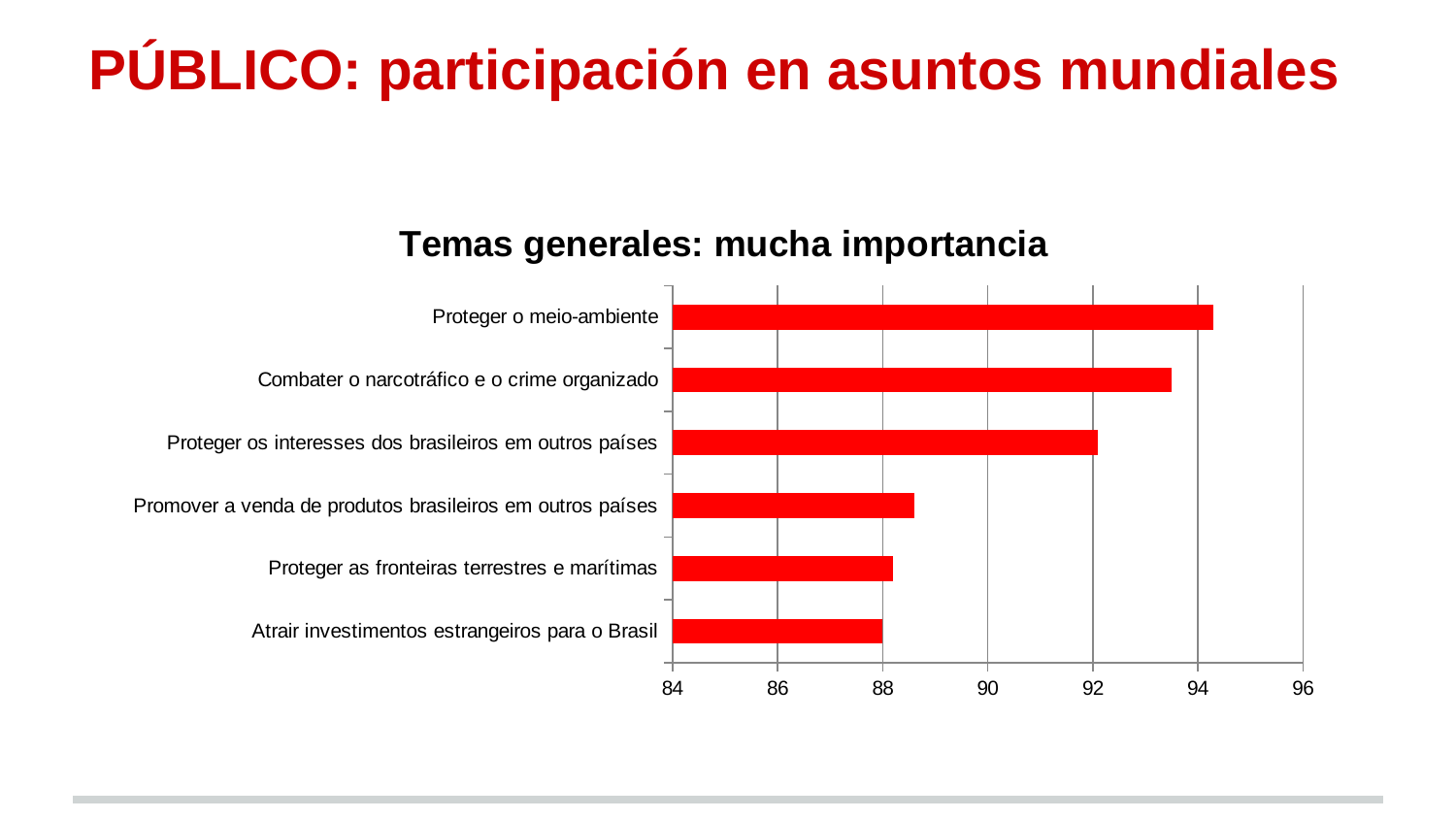
Is the value for Proteger o meio-ambiente greater or less than 92? greater What type of chart is shown on the slide? bar chart How many categories are plotted in the chart? 6 Is the value for Atrair investimentos estrangeiros para o Brasil greater or less than 90? less What is the title of the chart? Temas generales: mucha importancia Is the value for Proteger as fronteiras terrestres e marítimas greater or less than 90? less What colour are the bars in the chart? red Which is larger: the value for Proteger o meio-ambiente or the value for Promover a venda de produtos brasileiros em outros países? Proteger o meio-ambiente Which category has the highest value in the chart? Proteger o meio-ambiente